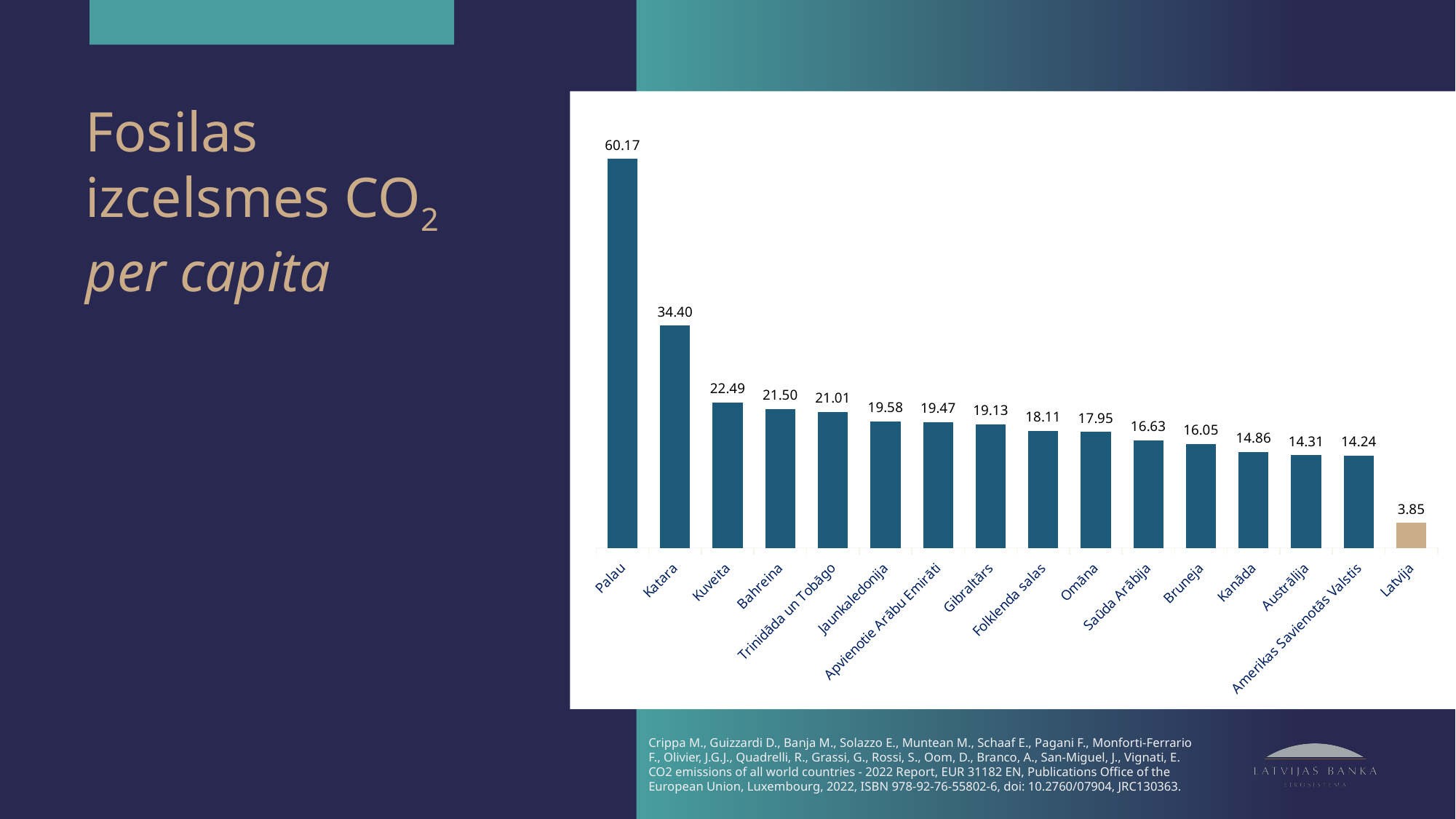
What is the value shown for Palau? 60.17 Which category has the highest value? Palau Which has a larger value, Kuveita or Bahreina? Kuveita What is the difference between the values for Palau and Katara? 25.77 What is the value shown for Katara? 34.40 What kind of chart is shown on the slide? Bar chart Which category has the lowest value? Latvija What is the value shown for Amerikas Savienotās Valstis? 14.24 Do the values rise or fall from left to right along the x axis? Fall What is the difference between the values for Kanāda and Latvija? 11.01 How many categories are shown on the chart? 16 What is the value shown for Latvija? 3.85